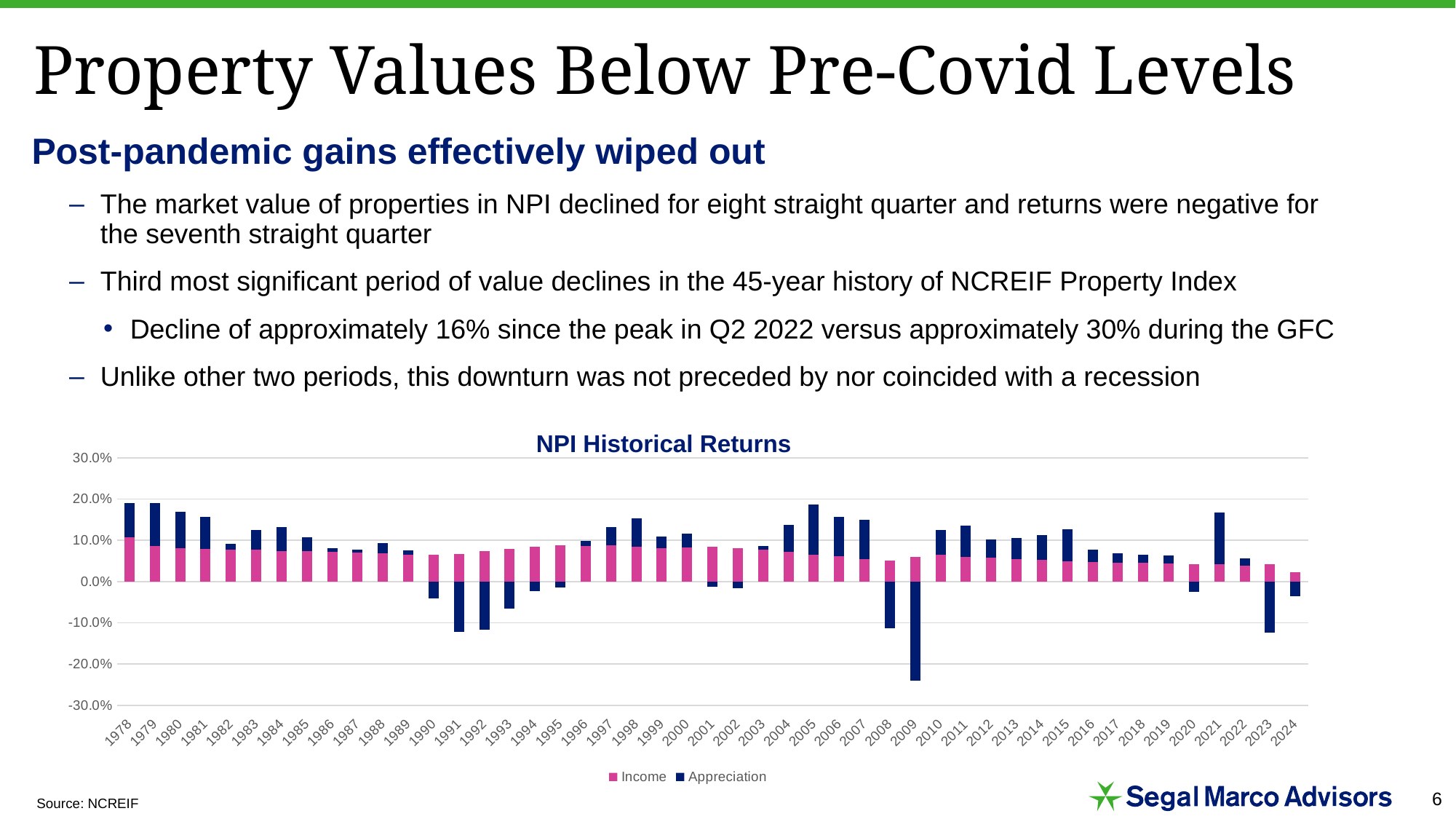
In the 'NPI Historical Returns' chart, does the Income series generally rise or fall from 1978 to 2024? fall How many series does the legend of the 'NPI Historical Returns' chart list? 2 What kind of chart is 'NPI Historical Returns'? Stacked bar chart In the 'NPI Historical Returns' chart, is the Appreciation value for 2005 greater or less than 10.0%? greater In the 'NPI Historical Returns' chart, is the Appreciation value for 2009 greater or less than -20.0%? less In the 'NPI Historical Returns' chart, is the Appreciation value for 2021 greater or less than 10.0%? greater In the 'NPI Historical Returns' chart, which year has the lowest Appreciation value? 2009 In the 'NPI Historical Returns' chart, which year has a lower Appreciation value, 2008 or 2009? 2009 What are the two series named in the legend of the 'NPI Historical Returns' chart? Income and Appreciation In the 'NPI Historical Returns' chart, which year has a larger Appreciation value, 2021 or 2022? 2021 How many years are shown on the x axis of the 'NPI Historical Returns' chart? 47